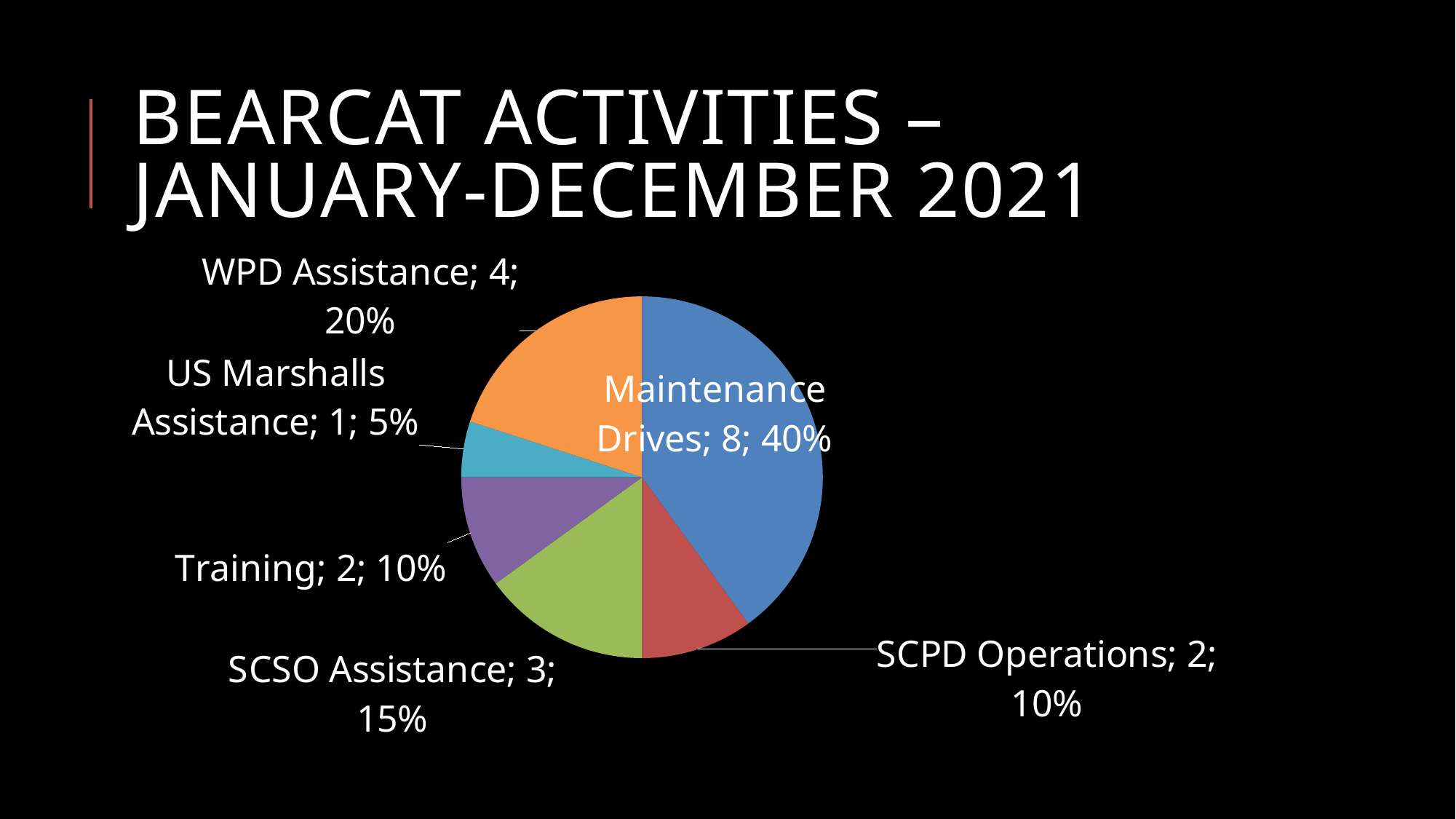
Which is larger, the value for SCSO Assistance or the value for SCPD Operations? SCSO Assistance What is the value for SCSO Assistance? 3 What is the difference between the values for Maintenance Drives and WPD Assistance? 4 How many slices does the pie chart have? 6 What is the title of the slide containing the chart? Bearcat Activities – January-December 2021 What is the value for Maintenance Drives? 8 Which category has the smallest slice? US Marshalls Assistance What share of the pie does WPD Assistance represent? 20% What type of chart is shown on the slide? pie chart What share of the pie does Training represent? 10% What is the value for US Marshalls Assistance? 1 Which category has the largest slice? Maintenance Drives